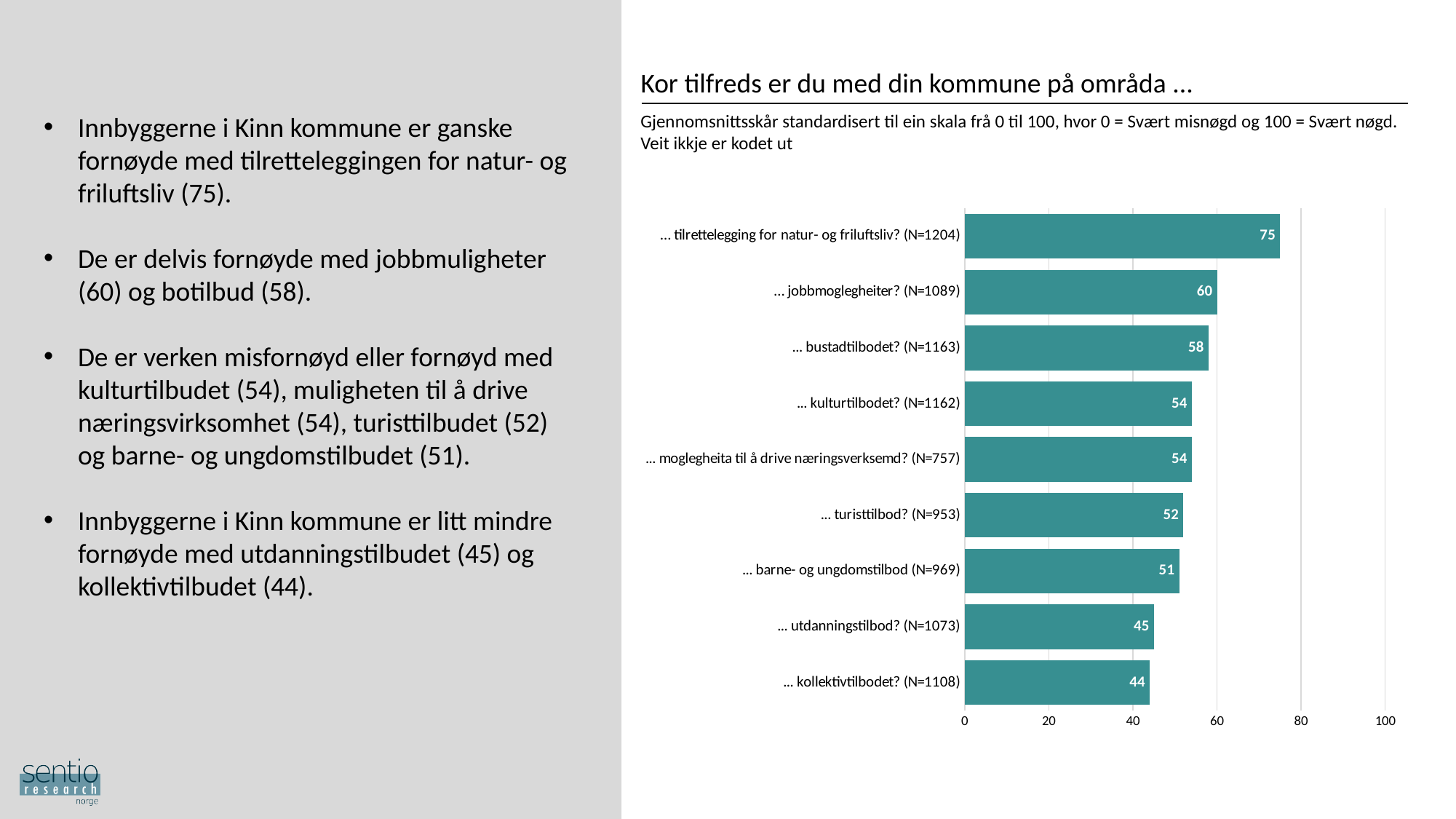
Which category has the highest value? ... tilrettelegging for natur- og friluftsliv? (N=1204) Which is larger, the value for "... utdanningstilbod? (N=1073)" or the value for "... barne- og ungdomstilbod (N=969)"? ... barne- og ungdomstilbod (N=969) How many categories are shown in the chart? 9 What is the difference between the values for "... jobbmoglegheiter? (N=1089)" and "... bustadtilbodet? (N=1163)"? 2 What kind of chart is shown on the slide? bar chart What is the value for "... turisttilbod? (N=953)"? 52 Is the value for "... jobbmoglegheiter? (N=1089)" greater or less than 40? greater What is the value for "... kollektivtilbodet? (N=1108)"? 44 Which category has the lowest value? ... kollektivtilbodet? (N=1108) What is the value for "... tilrettelegging for natur- og friluftsliv? (N=1204)"? 75 What is the difference between the highest and lowest values in the chart? 31 What is the title of the chart? Kor tilfreds er du med din kommune på områda ...